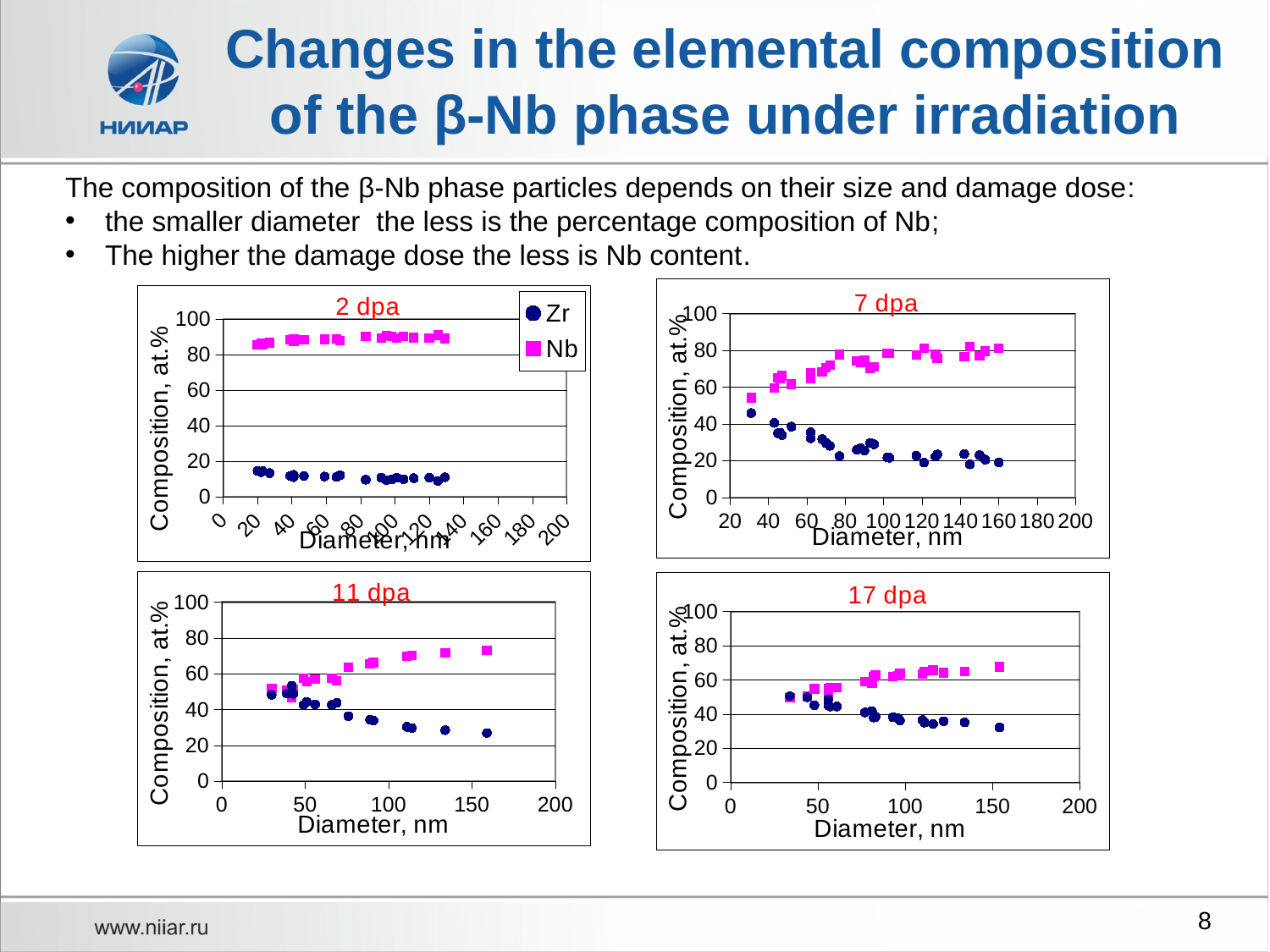
In the '11 dpa' chart, do the Nb values rise or fall as diameter increases? rise In the '11 dpa' chart, at a diameter of about 150 nm, which series has the higher value, Zr or Nb? Nb In the '11 dpa' chart, are the Nb values at diameters above 100 nm greater or less than 60? greater In the '7 dpa' chart, do the Zr values rise or fall as diameter increases? fall In the '17 dpa' chart, is the Zr value at a diameter of about 150 nm greater or less than 40? less In the '2 dpa' chart, are the Nb values greater or less than 80? greater In the '17 dpa' chart, at a diameter of about 150 nm, which series has the higher value, Zr or Nb? Nb What is the x-axis label on the '7 dpa' chart? Diameter, nm What kind of chart is the '2 dpa' chart? scatter chart How many series does the legend on the '2 dpa' chart list? 2 What are the two legend entries shown on the '2 dpa' chart? Zr and Nb